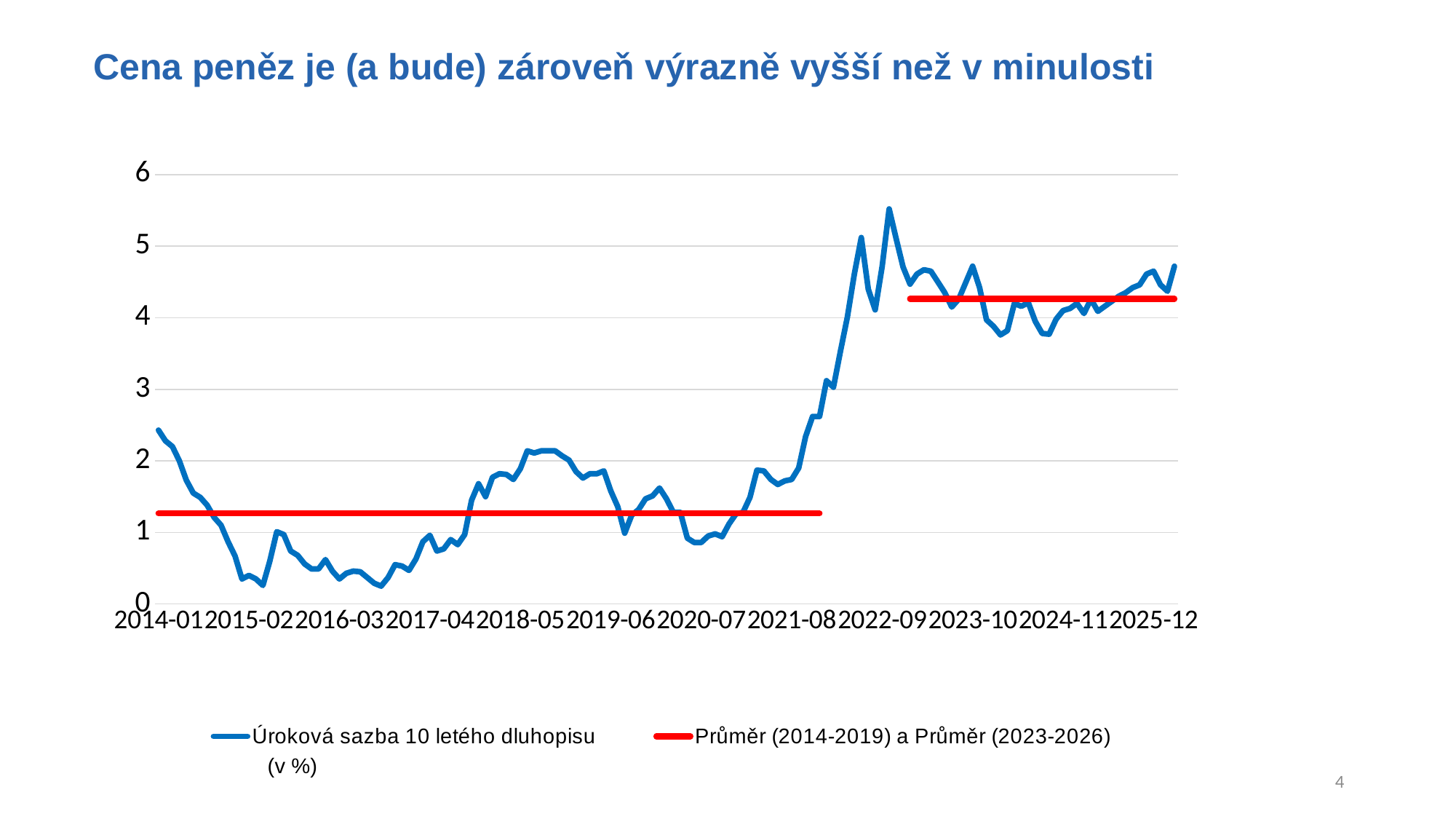
Is the value of the 10-year bond interest rate at 2014-01 greater or less than 2? greater Is the red average line for 2023-2026 (Průměr) greater or less than 4? greater How many date labels are shown on the x axis? 12 Which red average line is higher: Průměr (2014-2019) or Průměr (2023-2026)? Průměr (2023-2026) Between 2021-08 and 2022-09, does the blue line rise or fall? rise Is the highest value reached by the blue line (Úroková sazba 10 letého dluhopisu) greater or less than 5? greater How many series does the legend list? 2 Between 2014-01 and 2015-02, does the blue line rise or fall? fall What kind of chart is shown on the slide? line chart What is the title of the slide above the chart? Cena peněz je (a bude) zároveň výrazně vyšší než v minulosti